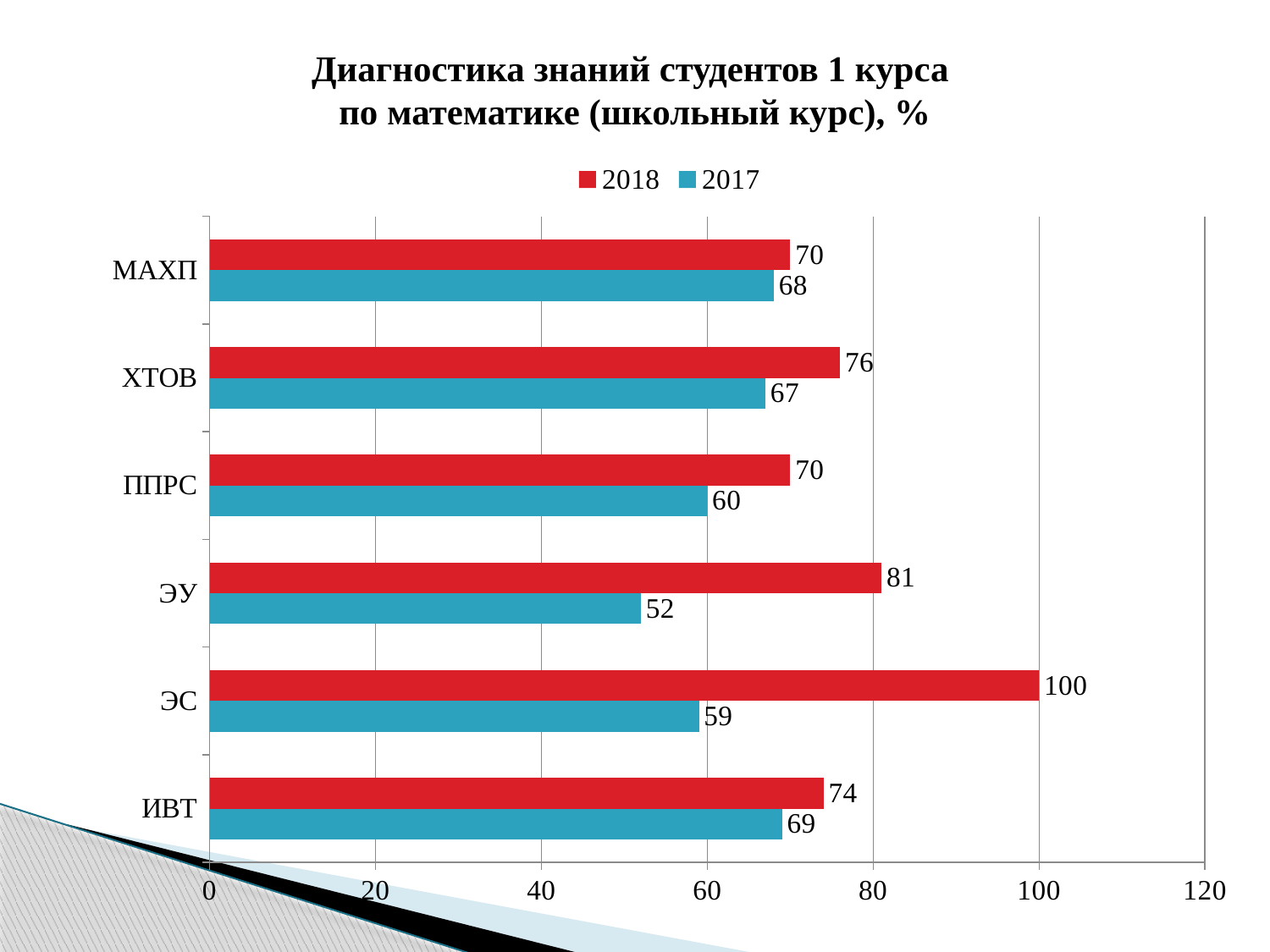
What is the difference between the 2018 and 2017 values for ЭУ? 29 What is the 2018 value for ЭС? 100 How many series does the legend list? 2 Which is larger for ППРС, the 2018 value or the 2017 value? 2018 What is the difference between the 2018 and 2017 values for ЭС? 41 What is the 2017 value for ХТОВ? 67 Which category has the lowest 2017 value? ЭУ Which category has the highest 2018 value? ЭС What is the 2017 value for ЭУ? 52 What kind of chart is shown on the slide? bar chart Is the 2018 value for ЭУ greater or less than 80? greater How many categories are shown on the chart? 6